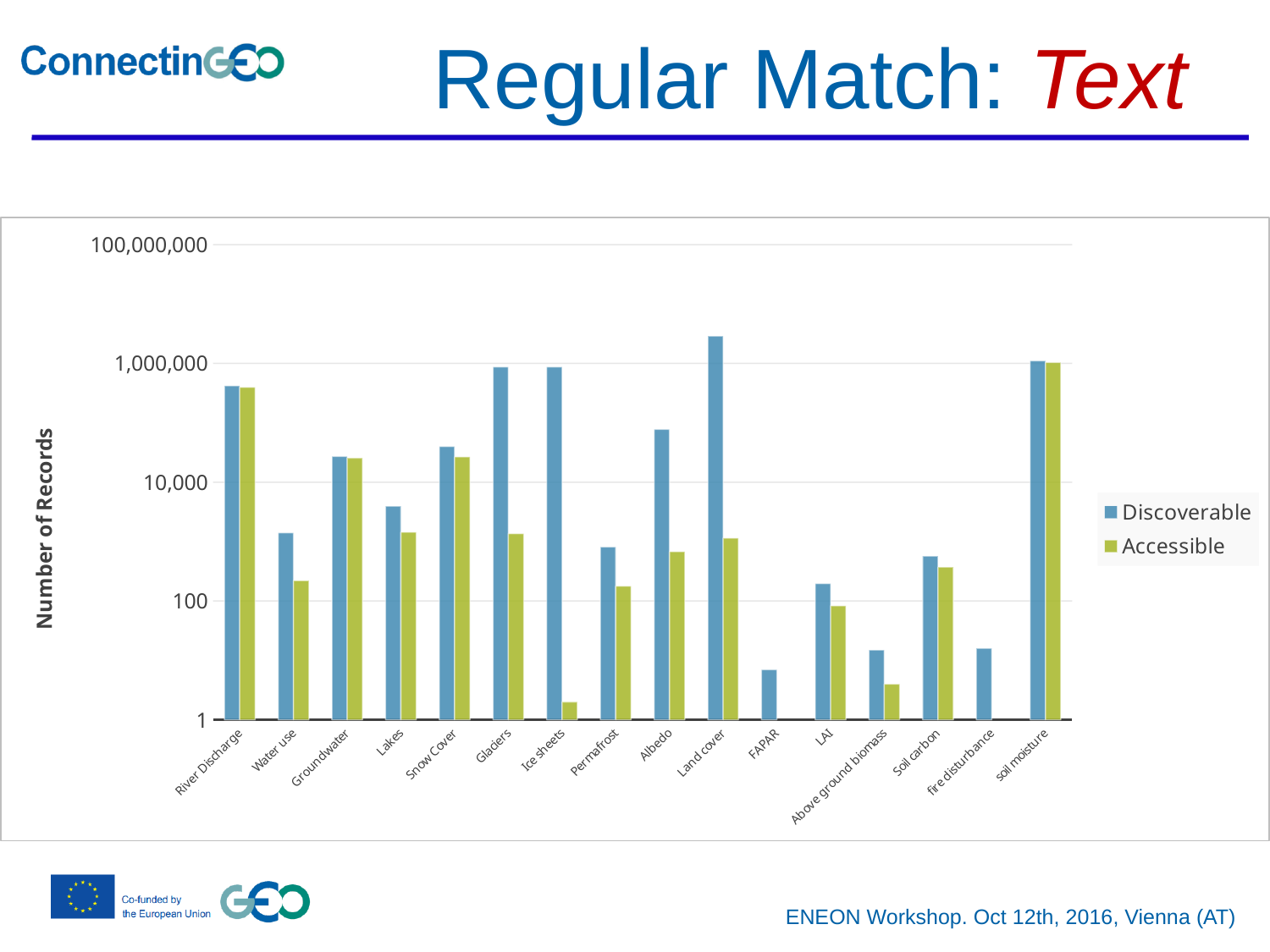
What kind of chart is shown on the slide? bar chart How many categories are shown along the x axis? 16 Which has the larger Discoverable value, Water use or Lakes? Lakes Is the Discoverable value for Lakes greater or less than 10,000? less Is the Discoverable value for Land cover greater or less than 1,000,000? greater Which category has the highest Discoverable value? Land cover Is the Accessible value for Ice sheets greater or less than 100? less How many series does the legend list? 2 What is the label on the y axis? Number of Records Which is larger for Ice sheets, the Discoverable value or the Accessible value? Discoverable